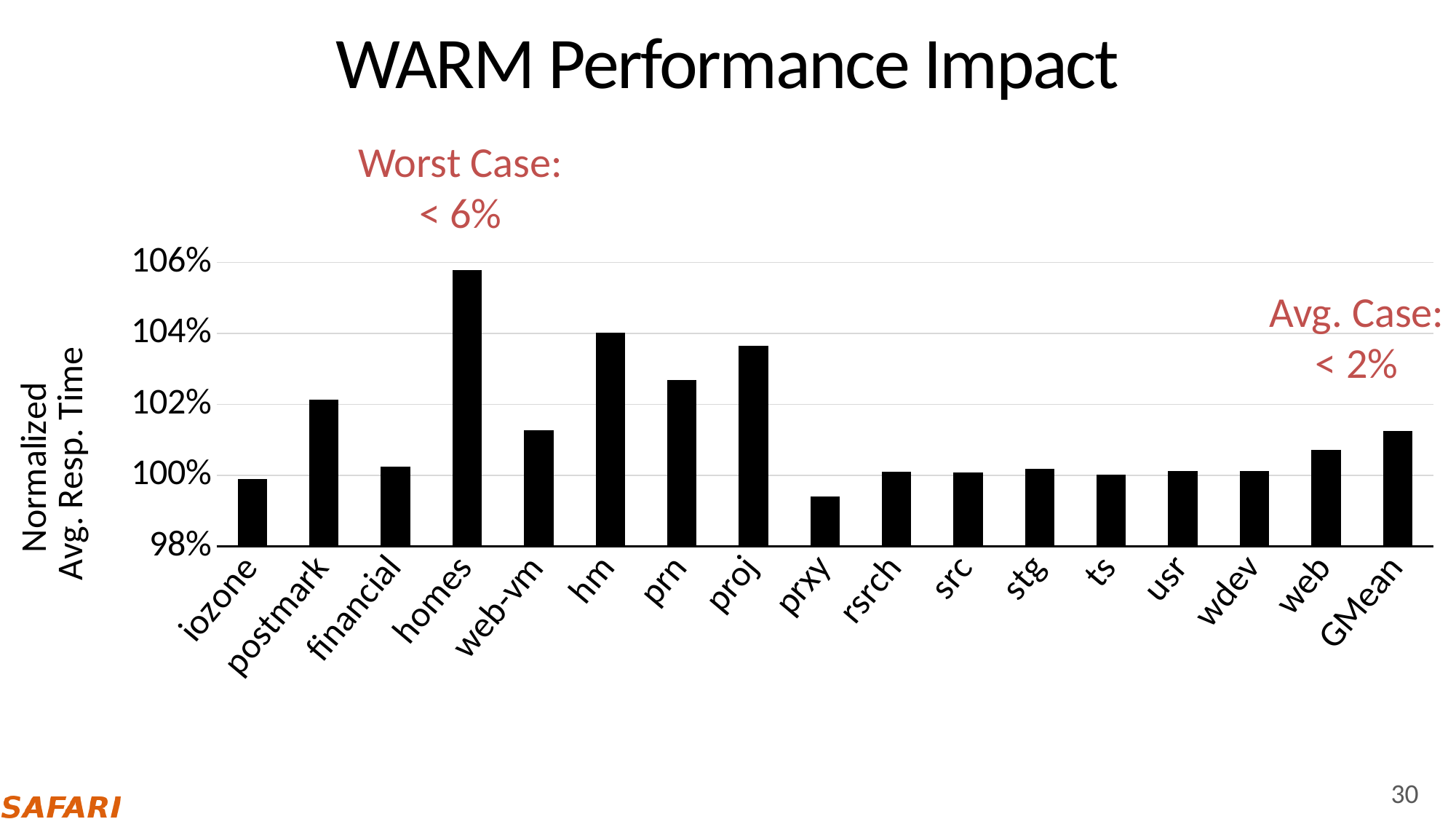
Is the value for prxy greater or less than 100%? less Which category has the highest normalized average response time? homes Which category has the lowest normalized average response time? prxy What is the label on the y axis? Normalized Avg. Resp. Time Is the value for GMean greater or less than 100%? greater What kind of chart is shown on the slide? bar chart Is the value for proj greater or less than 102%? greater What is the title of the slide's chart? WARM Performance Impact How many categories are plotted along the x axis? 17 Which has the larger value, postmark or web-vm? postmark Which has the larger value, homes or hm? homes